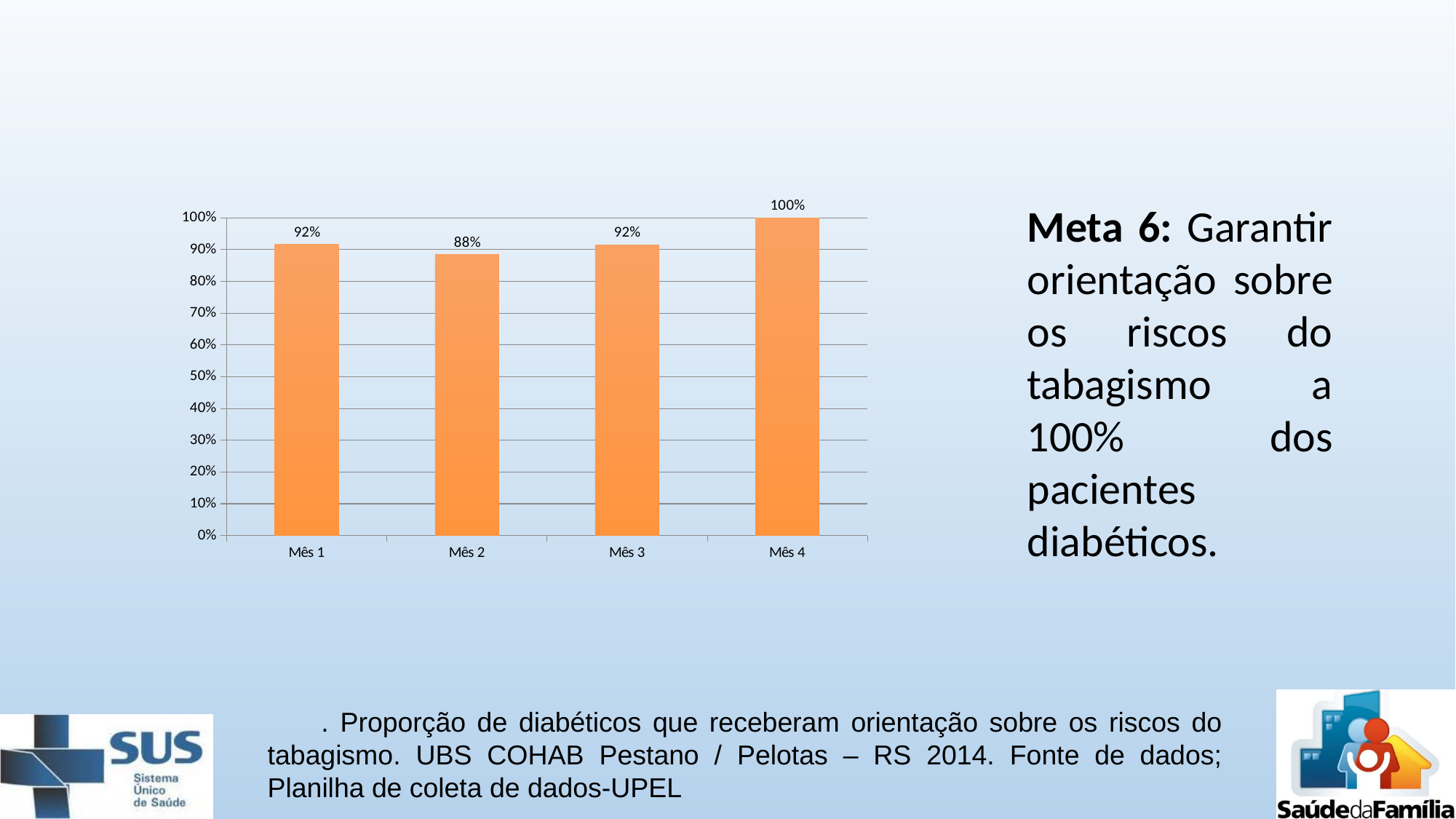
What kind of chart is shown on the slide? bar chart What colour are the bars in the chart? orange What is the value for Mês 2? 88% Which is larger, the value for Mês 1 or the value for Mês 2? Mês 1 How many months are shown on the x axis? 4 Which month has the lowest value? Mês 2 Does the value rise or fall from Mês 3 to Mês 4? rise Which month has the highest value? Mês 4 What is the value for Mês 4? 100% What is the value for Mês 1? 92% What is the difference between the values for Mês 4 and Mês 2? 12 percentage points Is the value for Mês 2 greater or less than 80%? greater